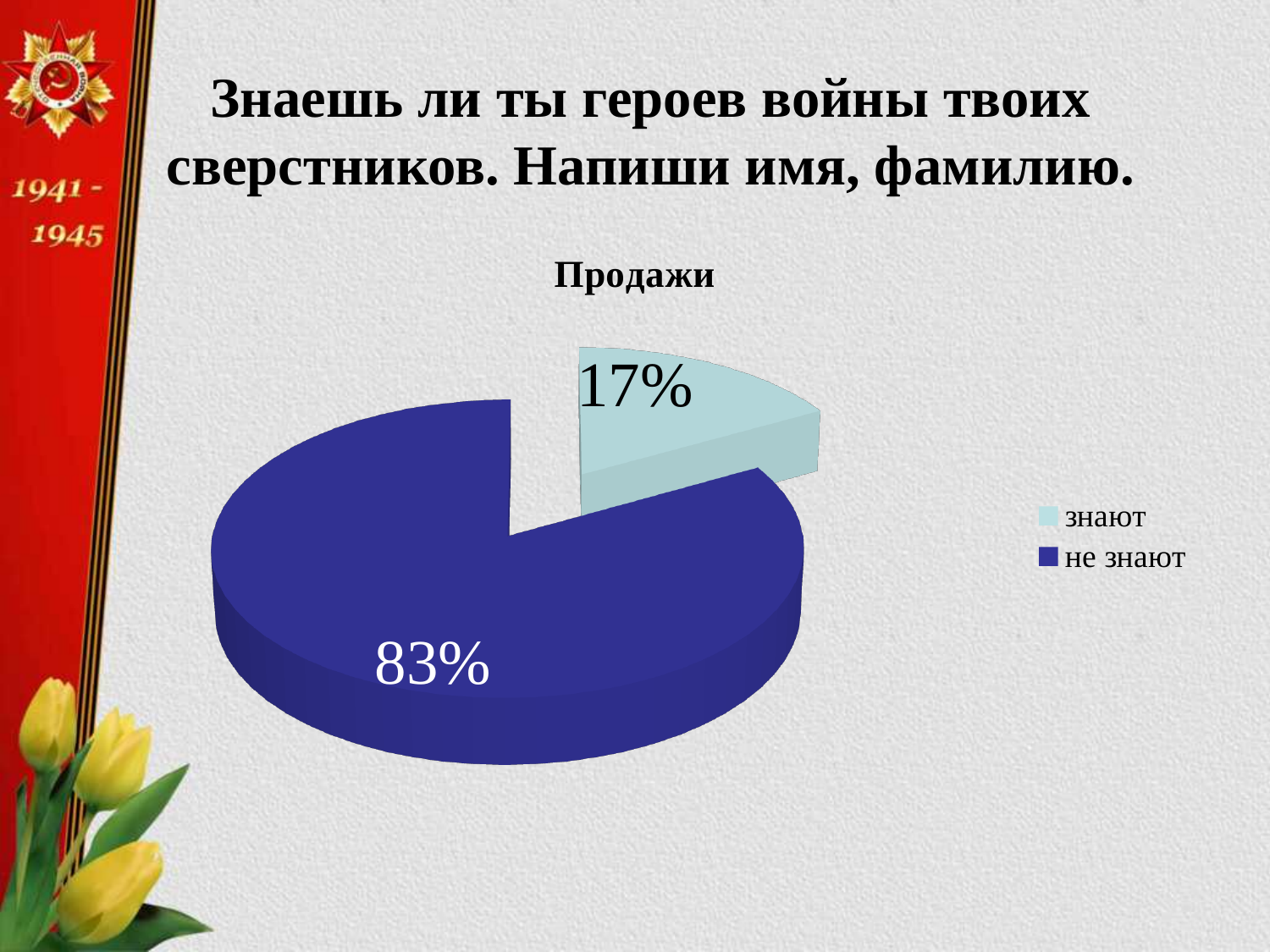
Which is larger, "знают" or "не знают"? не знают How many slices does the pie chart have? 2 Which category has the smallest slice? знают What is the value for "знают"? 17% What colour is the "не знают" slice? dark blue Which category has the largest slice? не знают What is the title of the chart? Продажи What share of the pie does the "знают" slice take? 17% What kind of chart is shown on the slide? pie chart How many entries does the legend list? 2 What is the value for "не знают"? 83% What is the difference between the "не знают" and "знают" values? 66%